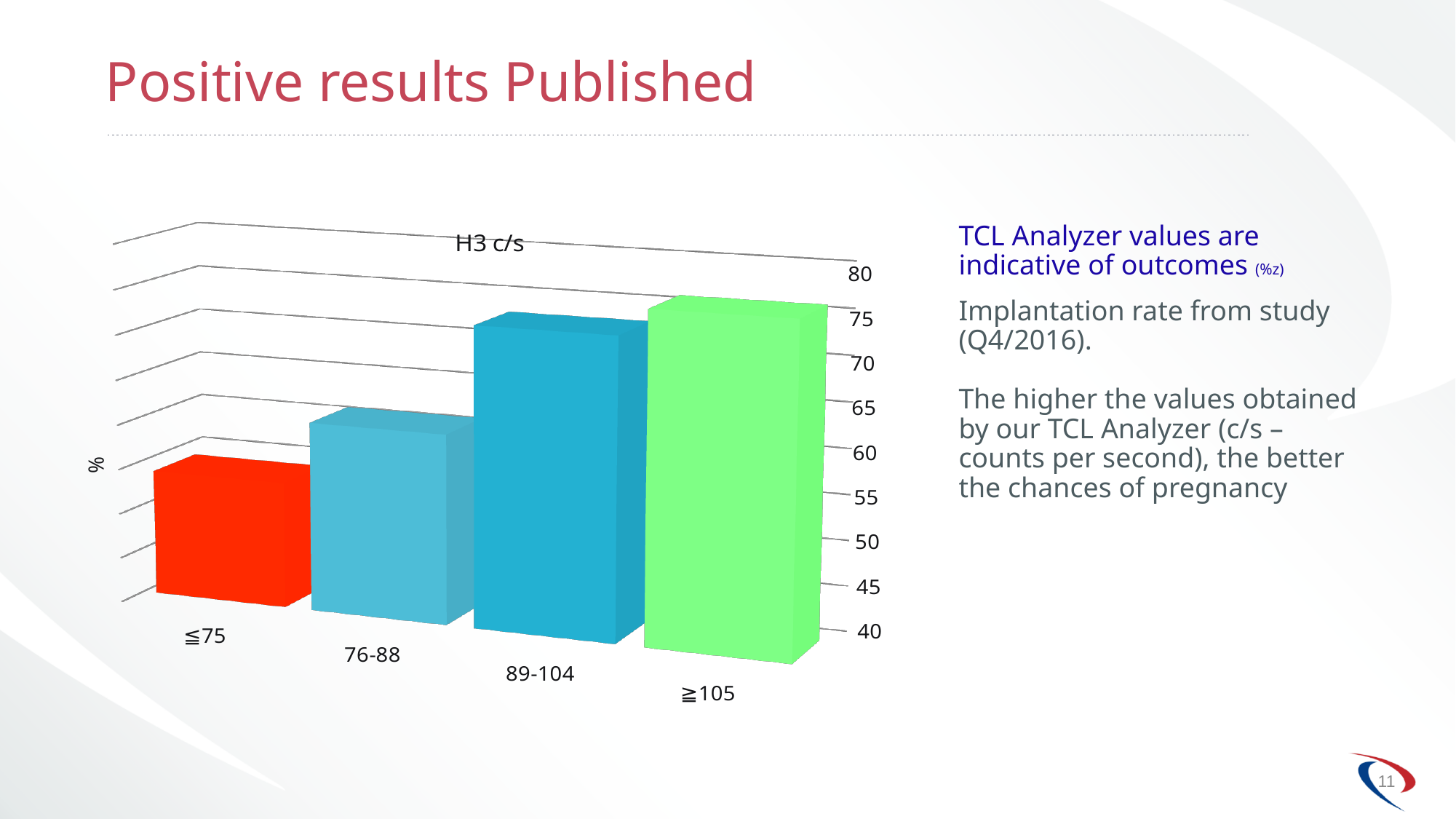
Do the values rise or fall as you move from ≦75 to ≧105 along the x axis? rise Is the value for 89-104 greater or less than 65? greater What label is shown on the vertical axis of the chart? % How many categories are shown on the x axis of the chart? 4 What kind of chart is shown on the slide? bar chart Which category has the highest value in the chart? ≧105 Which has a larger value, ≦75 or ≧105? ≧105 What is the title of the chart? H3 c/s Which has a larger value, 76-88 or 89-104? 89-104 Which category has the lowest value in the chart? ≦75 Is the value for ≦75 greater or less than 70? less Is the value for ≧105 greater or less than 70? greater